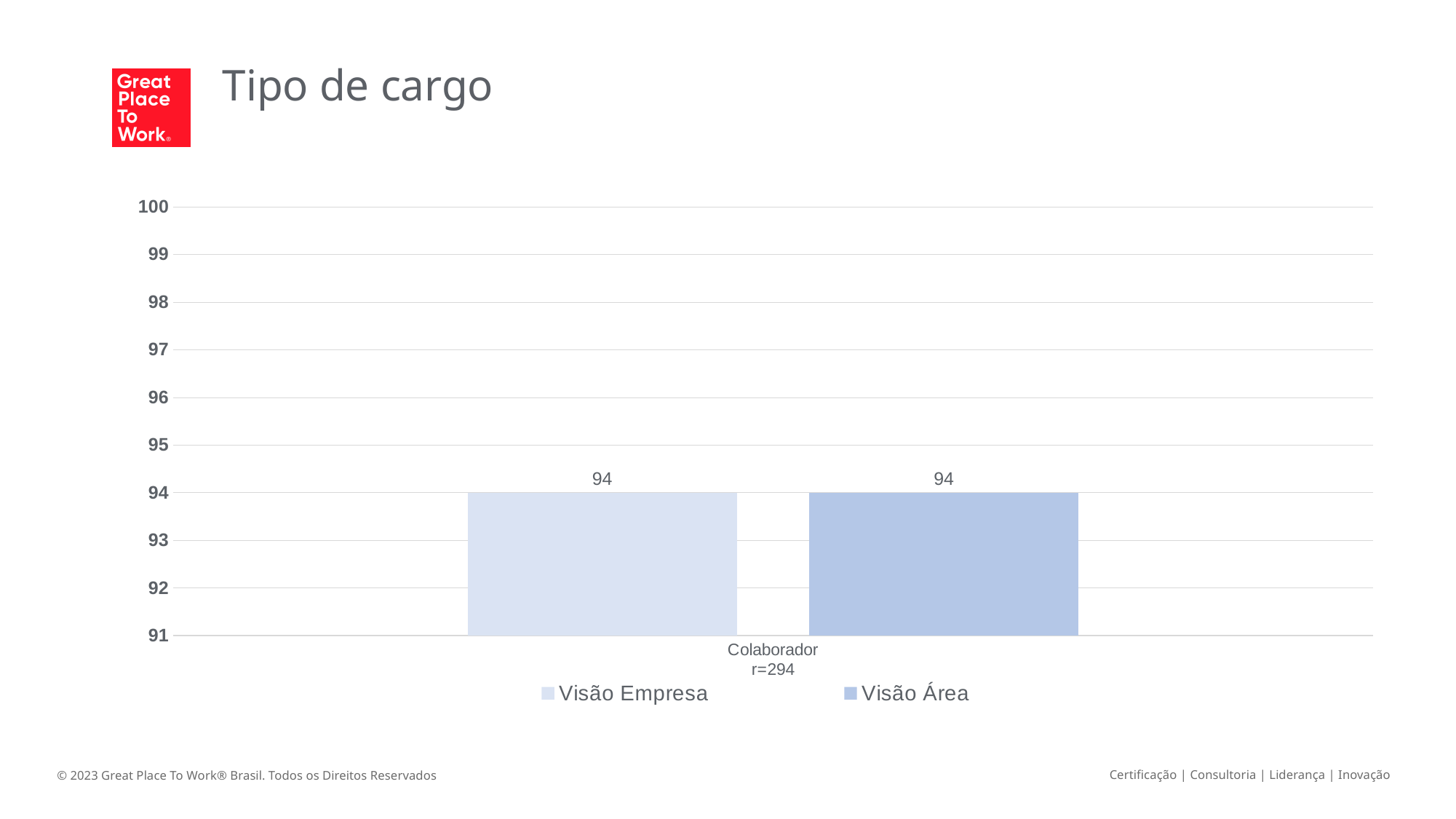
What is the difference between the Visão Empresa and Visão Área values for Colaborador? 0 What is the title of the slide? Tipo de cargo How many categories are shown on the x axis? 1 Is the value for Visão Empresa for Colaborador greater or less than 95? less Is the value for Visão Área for Colaborador greater or less than 92? greater What is the highest value shown on the y axis? 100 What is the lowest value shown on the y axis? 91 What is the value for Visão Empresa for Colaborador? 94 What is the value for Visão Área for Colaborador? 94 How many series does the legend list? 2 What is the sample size (r) shown for the Colaborador category? r=294 What kind of chart is shown on the slide? bar chart